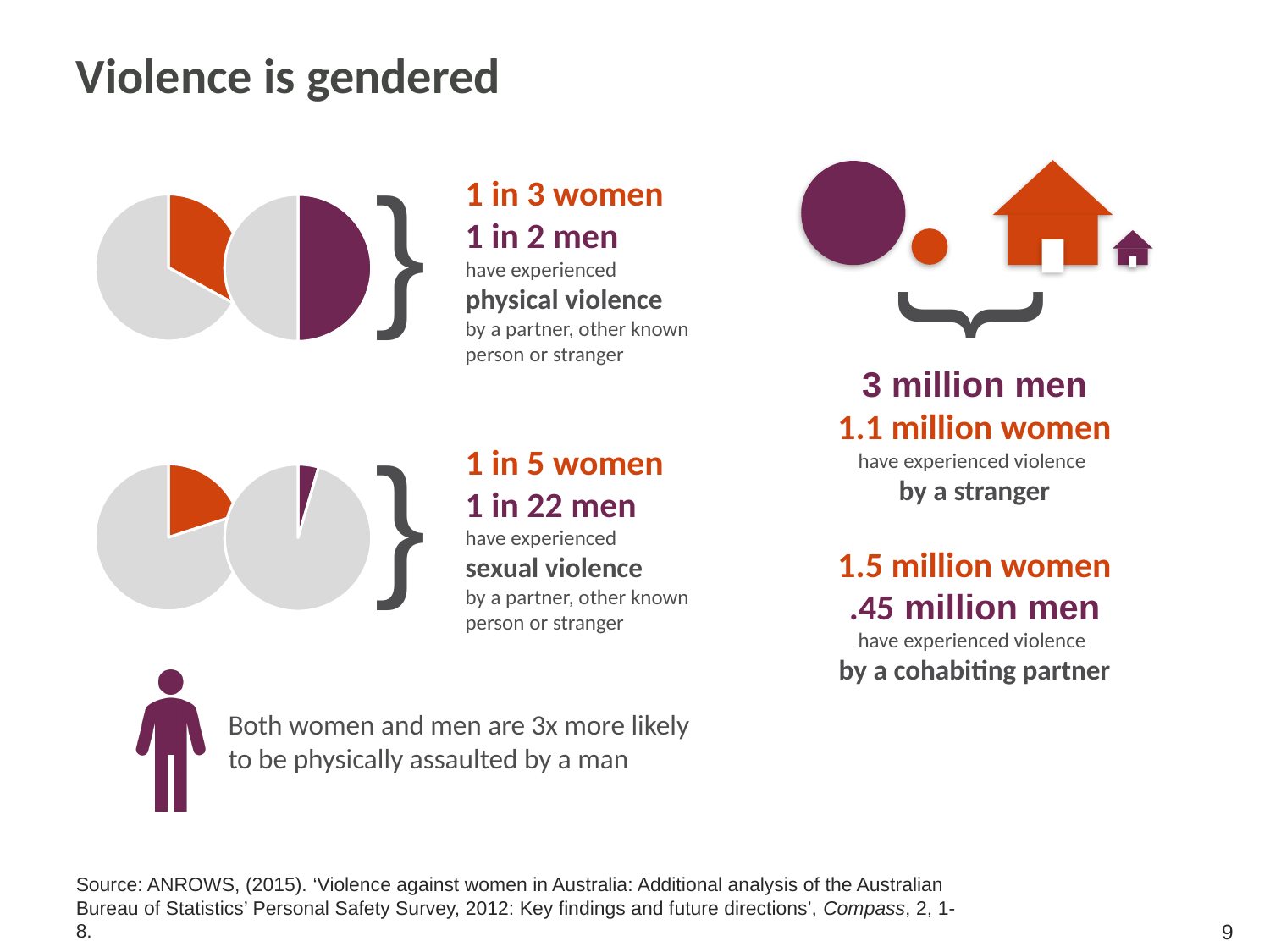
What kind of chart is used on the slide to show the proportions of women and men who have experienced physical violence? Pie chart In the pie chart for men who have experienced physical violence, what share of the pie is shaded? 1 in 2 In the sexual violence pie charts, which group has the larger shaded share, women or men? Women What colour is used for the men's slice in the pie charts? Purple In the top-left pie charts on physical violence, what proportion of men have experienced physical violence? 1 in 2 Comparing the two pie charts for women, which is larger: the share who have experienced physical violence or the share who have experienced sexual violence? Physical violence In the physical violence pie charts, which group has the larger shaded share, women or men? Men In the top-left pie charts on physical violence, what proportion of women have experienced physical violence? 1 in 3 What colour is used for the women's slice in the pie charts? Orange How many pie charts are shown on the slide? 4 In the bottom-left pie charts on sexual violence, what proportion of men have experienced sexual violence? 1 in 22 In the bottom-left pie charts on sexual violence, what proportion of women have experienced sexual violence? 1 in 5